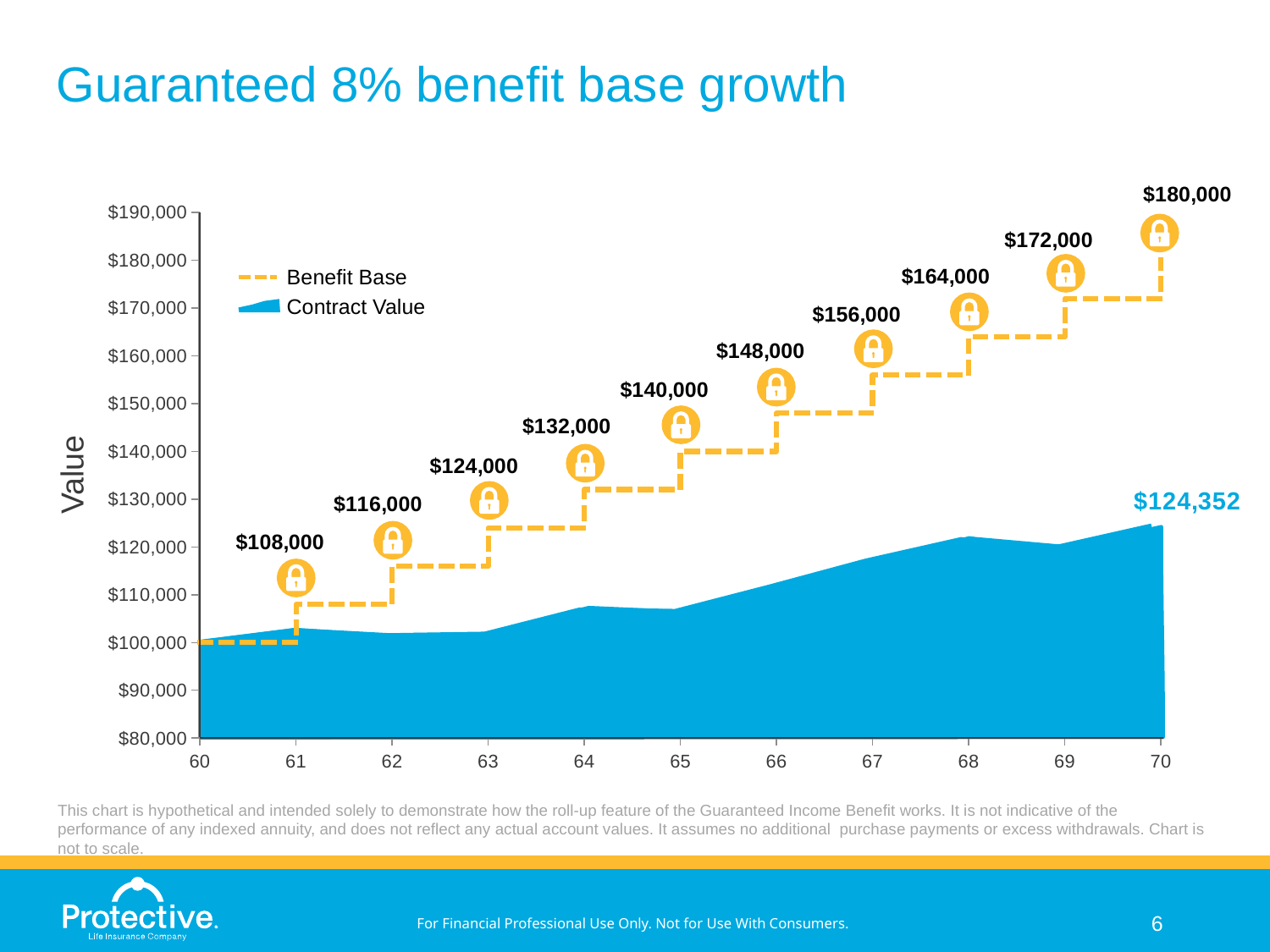
How many ages are shown on the x axis? 11 What is the Benefit Base value at age 65? $140,000 What is the difference between the Benefit Base and the Contract Value at age 70? $55,648 At age 70, which is larger: the Benefit Base or the Contract Value? Benefit Base At which age does the Benefit Base reach its highest labeled value? 70 How many series does the legend list? 2 What is the Benefit Base value at age 61? $108,000 What is the Contract Value at age 70? $124,352 What is the difference between the Benefit Base at age 70 and at age 61? $72,000 Is the Contract Value at age 64 greater or less than $110,000? less What is the Benefit Base value at age 68? $164,000 Does the Benefit Base rise or fall as age increases from 60 to 70? rise